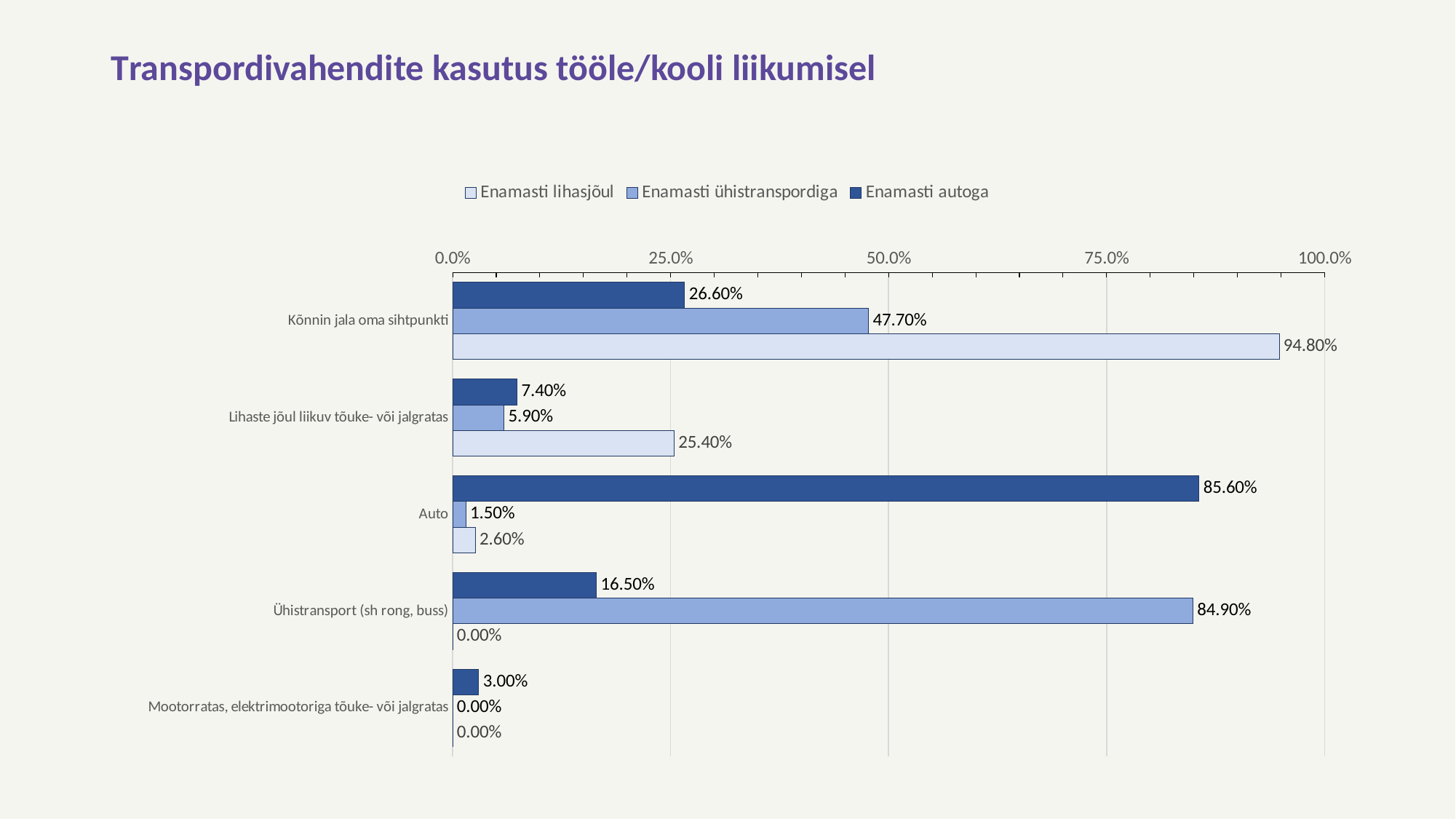
What is the value for "Auto" in the "Enamasti autoga" series? 85.60% How many series does the legend list? 3 What is the value for "Ühistransport (sh rong, buss)" in the "Enamasti ühistranspordiga" series? 84.90% What is the value for "Kõnnin jala oma sihtpunkti" in the "Enamasti lihasjõul" series? 94.80% What is the difference between the "Enamasti ühistranspordiga" and "Enamasti autoga" values for "Kõnnin jala oma sihtpunkti"? 21.10% How many categories are shown on the chart? 5 What is the value for "Lihaste jõul liikuv tõuke- või jalgratas" in the "Enamasti ühistranspordiga" series? 5.90% What is the title of the slide? Transpordivahendite kasutus tööle/kooli liikumisel Which category has the lowest value in the "Enamasti autoga" series? Mootorratas, elektrimootoriga tõuke- või jalgratas What kind of chart is shown on the slide? Bar chart For "Lihaste jõul liikuv tõuke- või jalgratas", which series has the larger value: "Enamasti autoga" or "Enamasti ühistranspordiga"? Enamasti autoga Which category has the highest value in the "Enamasti autoga" series? Auto